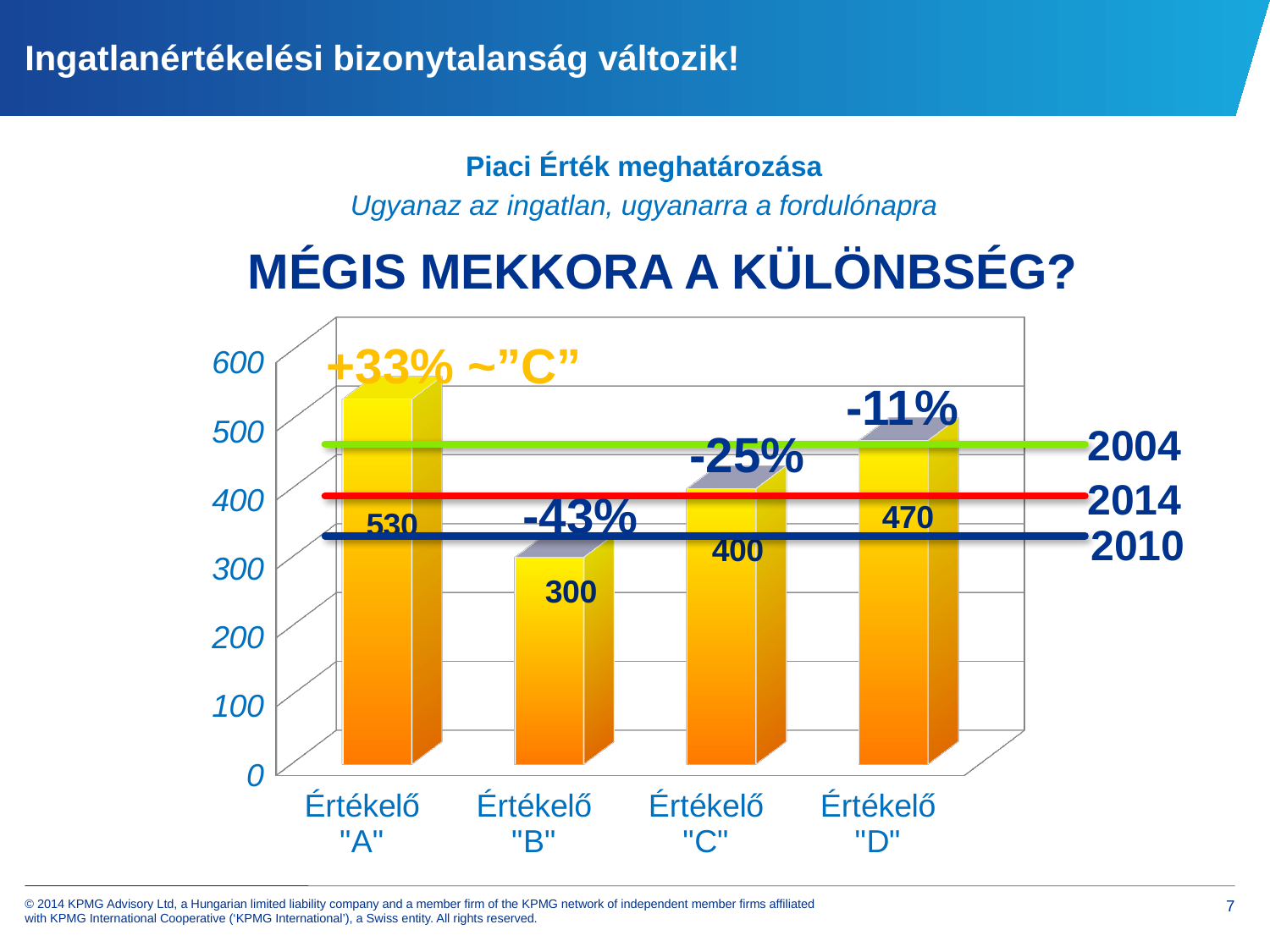
What year label is attached to the green horizontal line? 2004 Which category has the highest bar? Értékelő "A" What percentage annotation is shown above the bar for Értékelő "B"? -43% What kind of chart is shown on the slide? Bar chart What is the value for Értékelő "D"? 470 What is the value for Értékelő "C"? 400 What is the value for Értékelő "B"? 300 Which category has the lowest bar? Értékelő "B" Which is larger, the value for Értékelő "C" or Értékelő "D"? Értékelő "D" How many categories are shown on the x axis? 4 What is the difference between the values for Értékelő "A" and Értékelő "B"? 230 What is the value for Értékelő "A"? 530